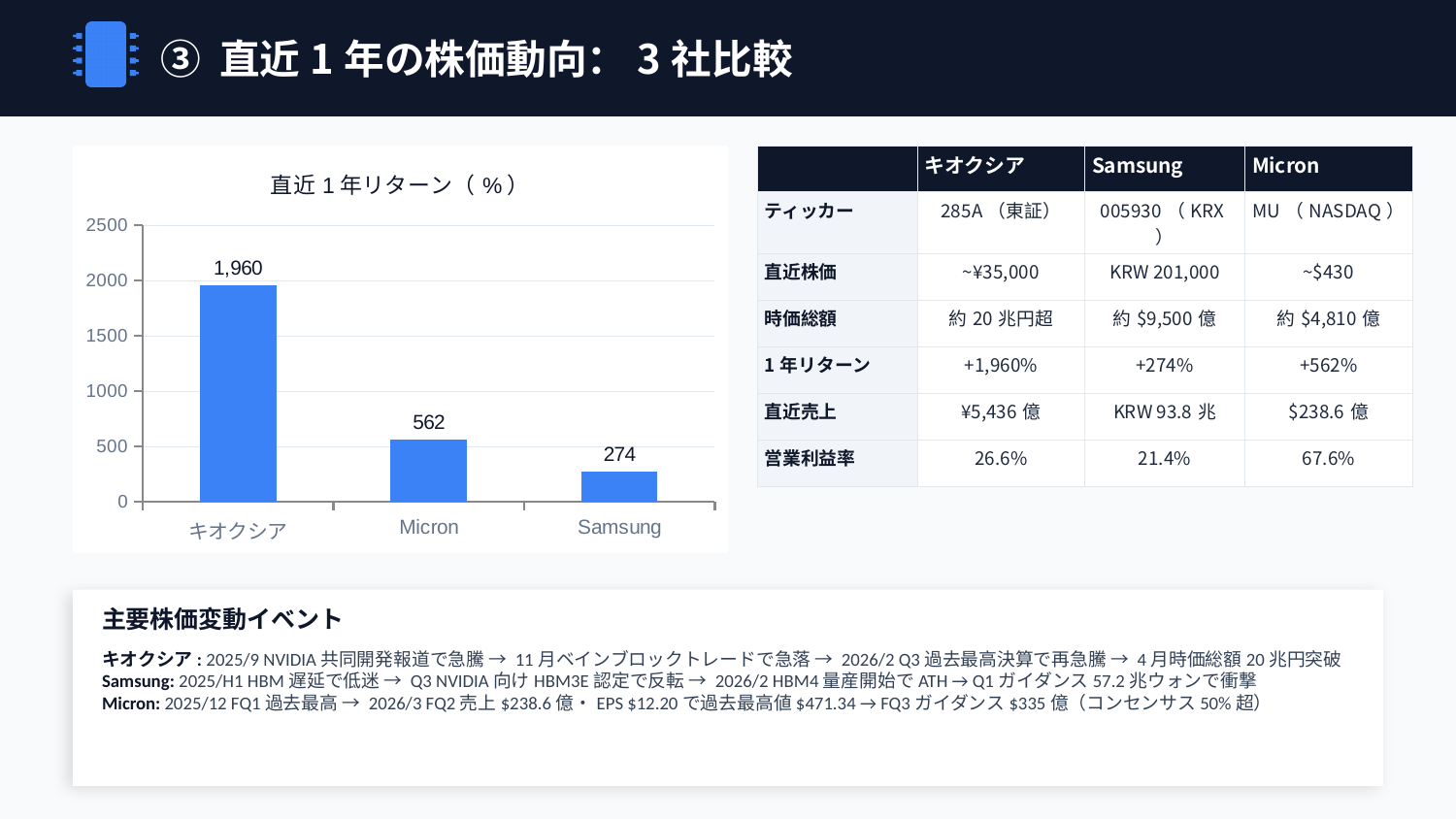
What is the value for キオクシア in the chart? 1,960 Which category has the lowest value in the chart? Samsung What kind of chart is shown on the slide? bar chart What is the value for Micron in the chart? 562 Which category has the highest value in the chart? キオクシア What is the difference between the values for キオクシア and Micron? 1,398 Which is larger, the value for Micron or the value for Samsung? Micron What is the title of the chart? 直近1年リターン（%） How many categories are shown in the chart? 3 What is the value for Samsung in the chart? 274 What is the difference between the values for Micron and Samsung? 288 Is the value for Micron greater or less than 500? greater